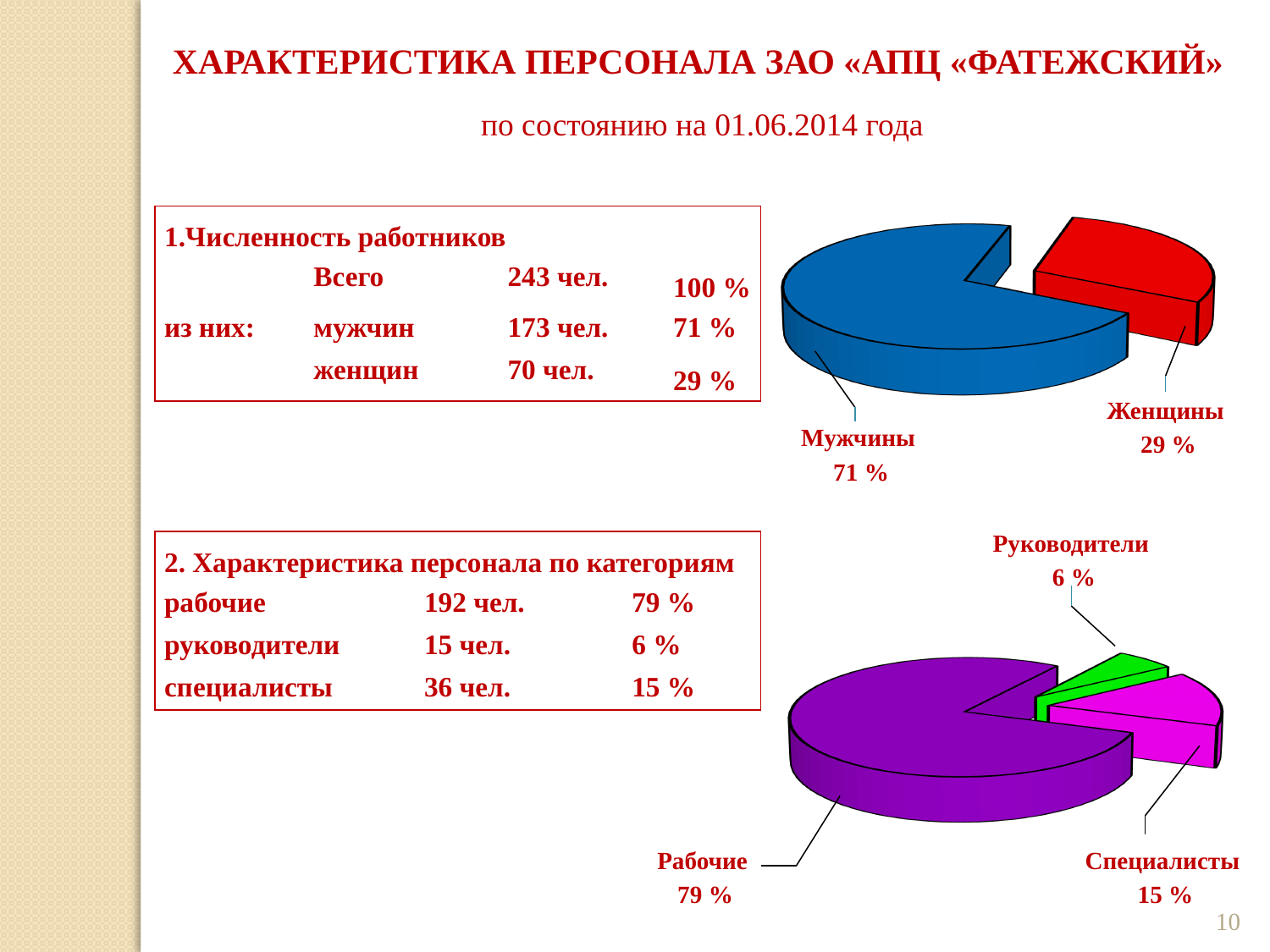
In the upper pie chart, what is the difference between the shares of Мужчины and Женщины? 42 % In the lower pie chart, what share is labelled for Рабочие? 79 % In the upper pie chart, what share is labelled for Мужчины? 71 % What kind of chart is the lower chart on the right of the slide? pie chart In the upper pie chart, what share is labelled for Женщины? 29 % In the lower pie chart, what colour is the Рабочие slice? purple In the lower pie chart, which is larger: Специалисты or Руководители? Специалисты In the lower pie chart, which slice is the smallest? Руководители What kind of chart is the upper chart on the right of the slide? pie chart How many slices does the upper pie chart have? 2 In the upper pie chart, which slice is the largest? Мужчины